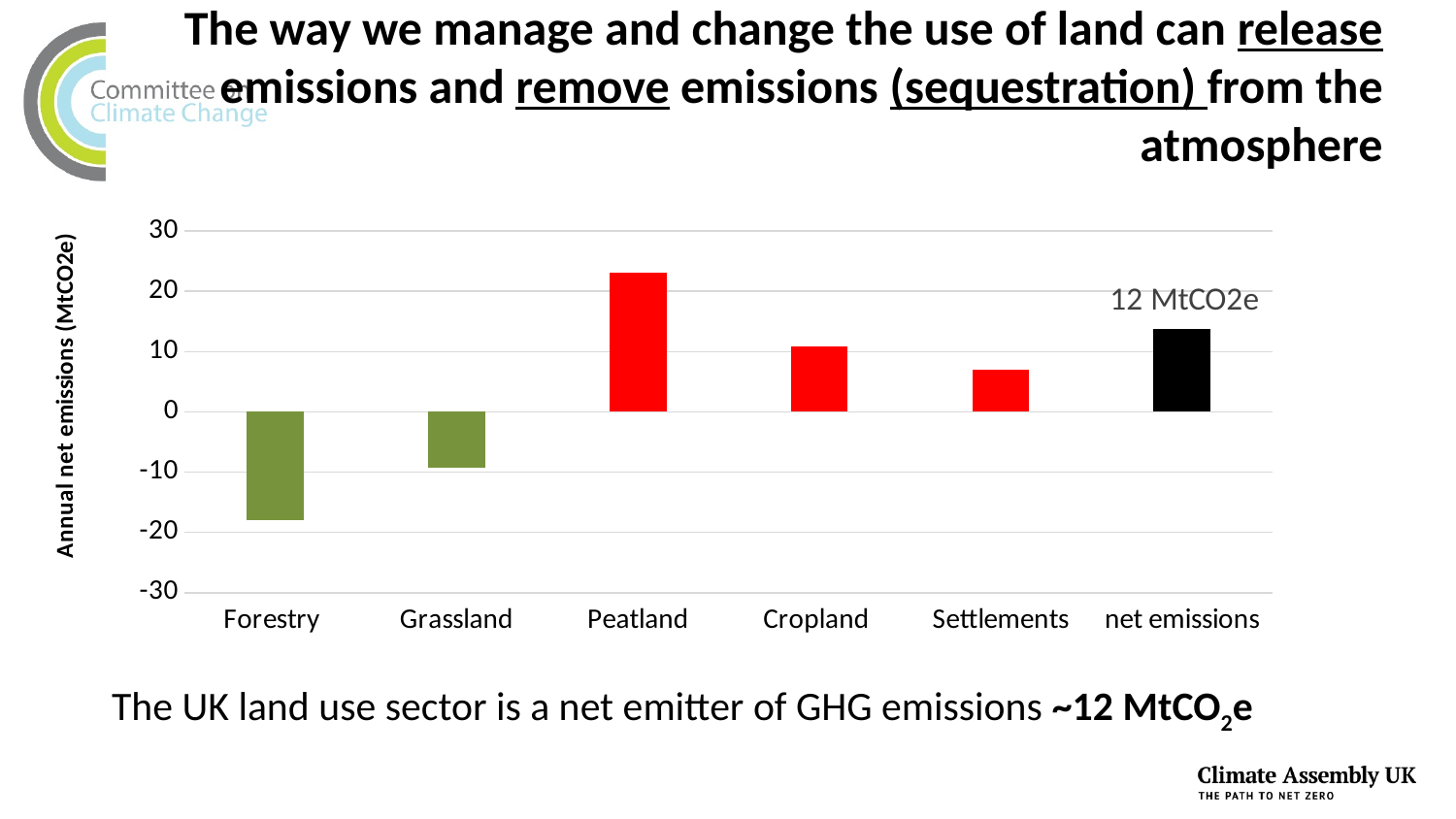
What is the label on the vertical axis of the chart? Annual net emissions (MtCO2e) How many categories in the chart have negative values? 2 Which category has the lowest (most negative) annual net emissions in the chart? Forestry Which category has the highest annual net emissions in the chart? Peatland Which is larger, the value for Peatland or the value for Cropland? Peatland Is the value for Forestry greater or less than -10? less What value is labelled on the net emissions bar? 12 MtCO2e Is the value for Settlements greater or less than 10? less Which is larger, the value for Cropland or the value for Settlements? Cropland How many categories are shown on the x axis of the chart? 6 Is the value for Peatland greater or less than 20? greater What kind of chart is shown on the slide? bar chart